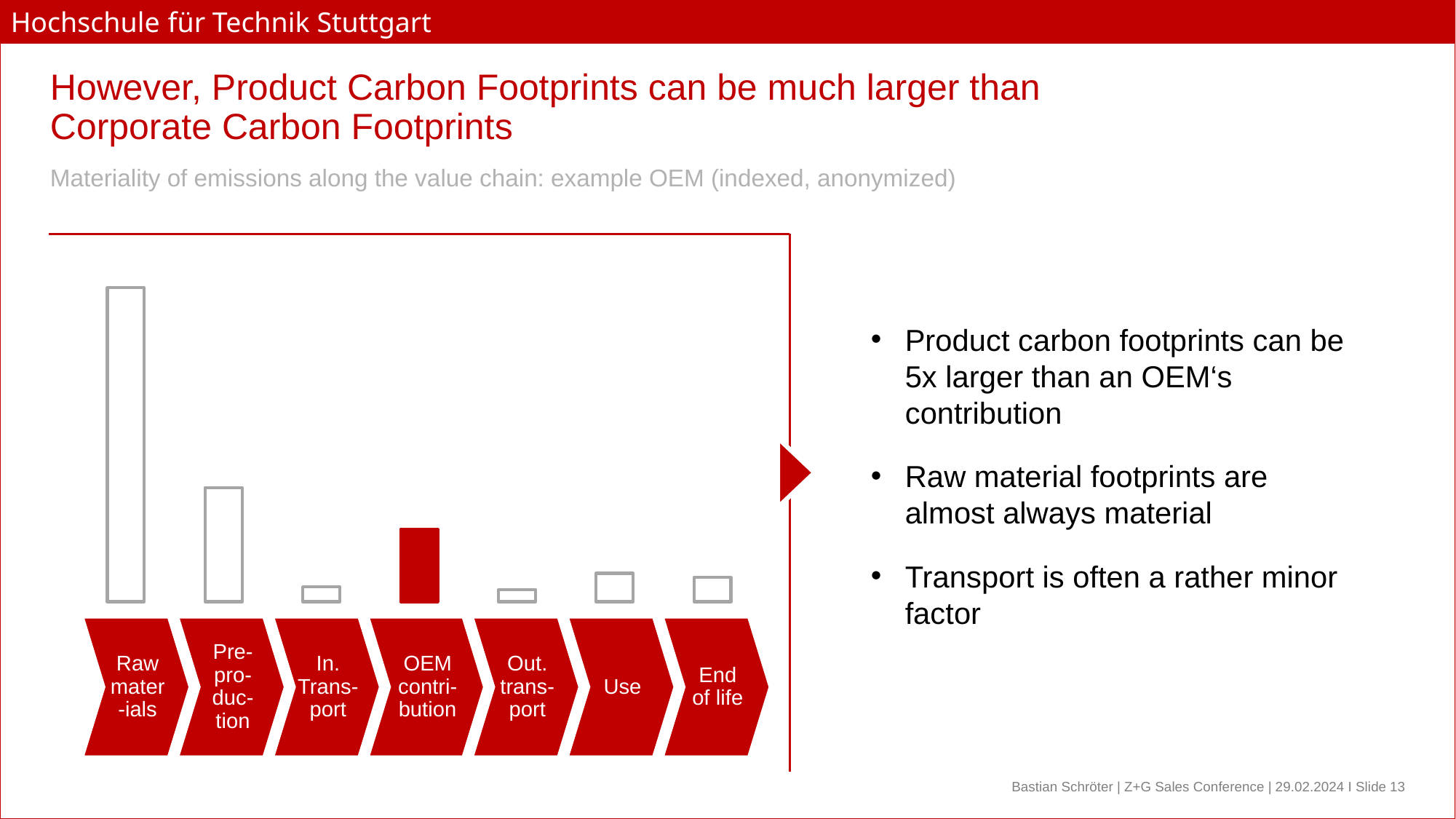
Which is larger in the chart, the bar for Use or the bar for In. Transport? Use Which is larger in the chart, the bar for Raw materials or the bar for Pre-production? Raw materials Which value chain stage is shown with a solid red bar in the chart? OEM contribution What kind of chart is shown on the slide? bar chart Which is larger in the chart, the bar for Raw materials or the bar for End of life? Raw materials Which value chain stage has the highest bar in the chart? Raw materials What is the first value chain stage shown on the left of the chart? Raw materials How many value chain stages (bars) are shown in the chart? 7